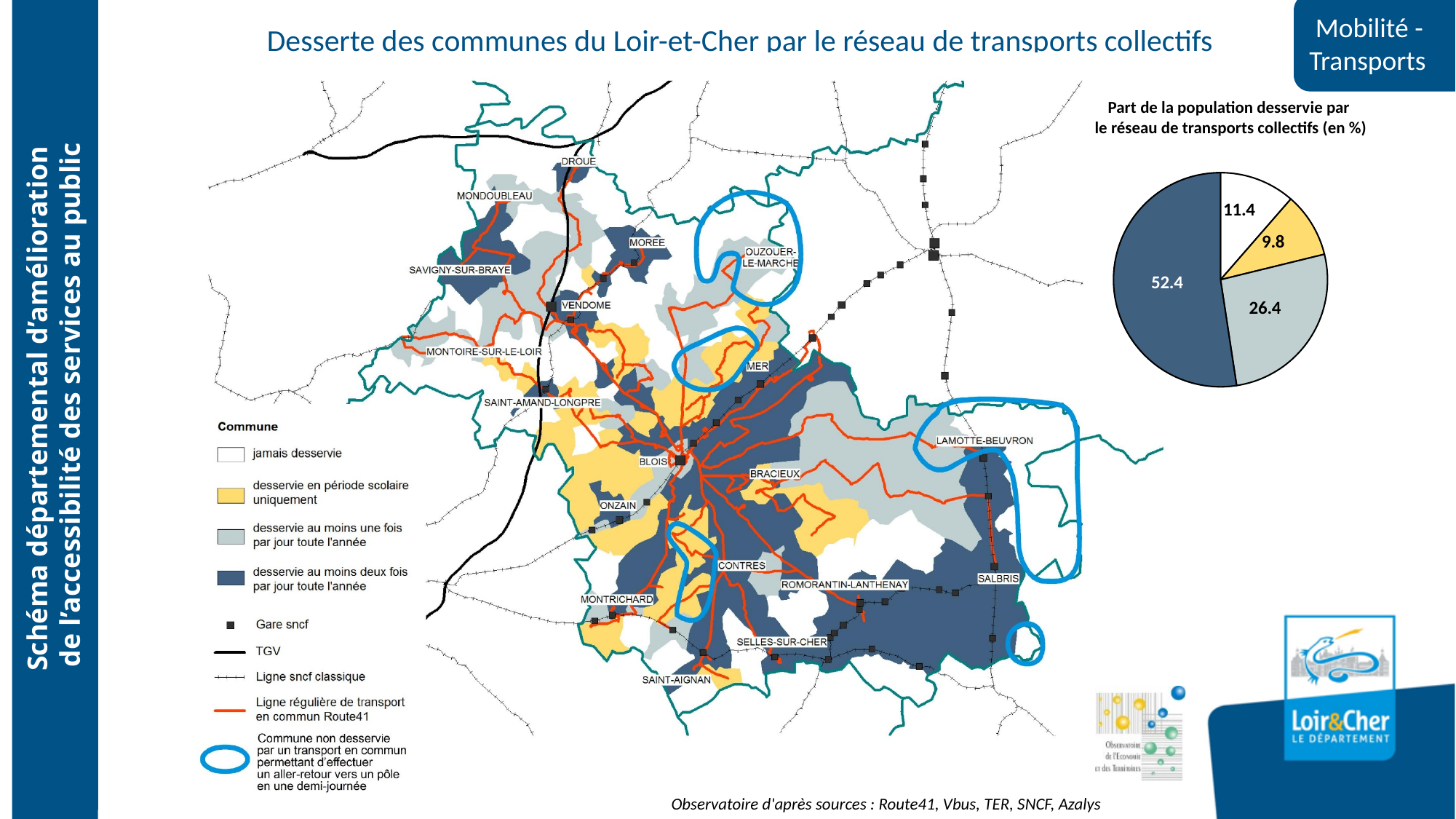
In the pie chart, what value is shown on the light grey slice? 26.4 What is the title of the pie chart? Part de la population desservie par le réseau de transports collectifs (en %) In the pie chart, which slice is larger: the white slice or the yellow slice? the white slice (11.4) How many slices does the pie chart have? 4 In the pie chart, what value is shown on the smallest slice? 9.8 In the pie chart, what value is shown on the dark blue slice? 52.4 In the pie chart, what is the difference between the dark blue slice (52.4) and the light grey slice (26.4)? 26 In the pie chart, what value is shown on the largest slice? 52.4 In the pie chart, what value is shown on the white slice? 11.4 In the pie chart, what value is shown on the yellow slice? 9.8 In the pie chart, what is the combined value of the white and yellow slices? 21.2 What kind of chart is shown at the top right of the slide? pie chart